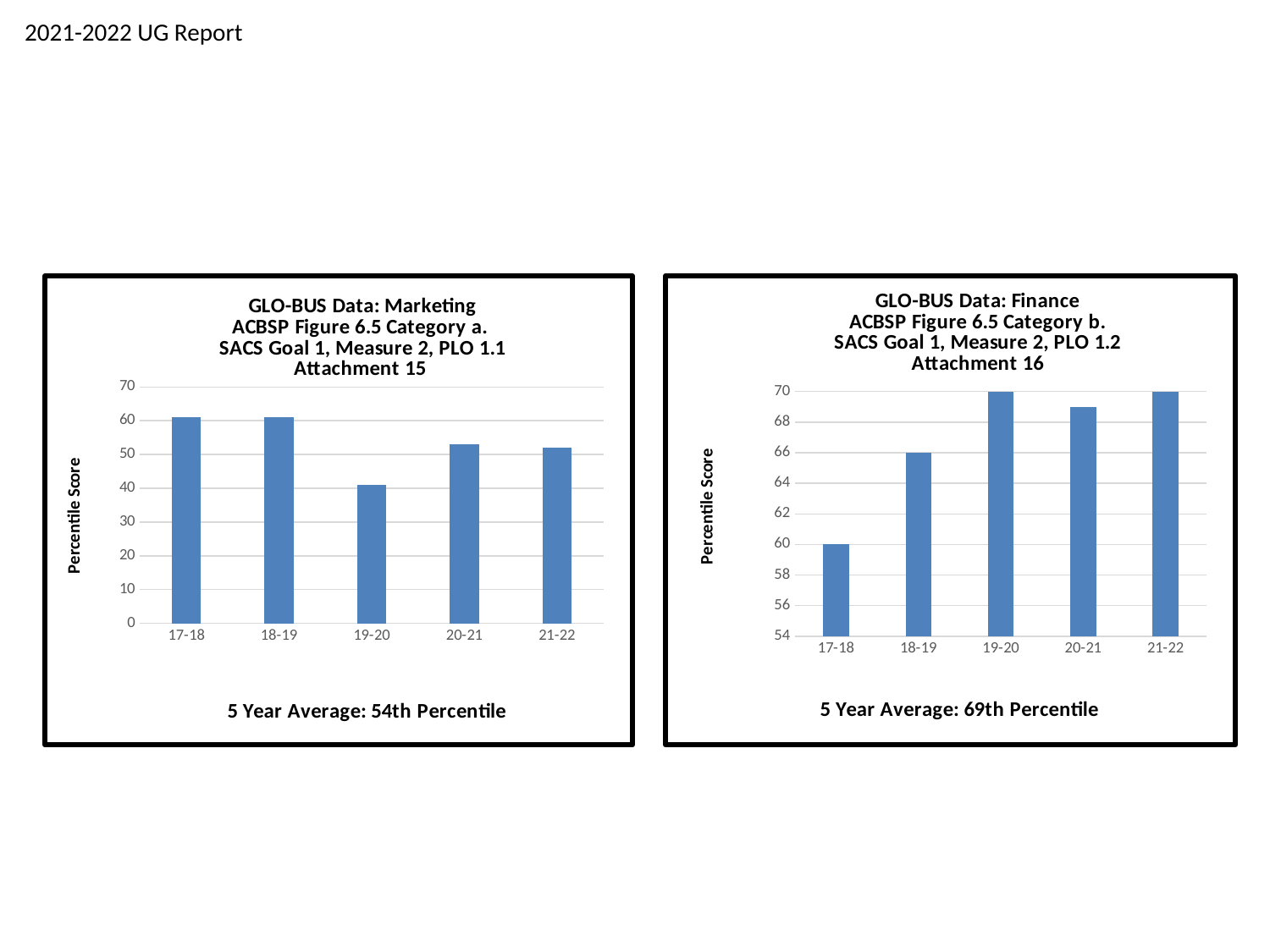
In the GLO-BUS Data: Marketing chart, which is larger, the value for 17-18 or the value for 19-20? 17-18 In the GLO-BUS Data: Marketing chart, is the value for 17-18 greater or less than 50? greater In the GLO-BUS Data: Finance chart, what is the percentile score for 17-18? 60 How many years are plotted in the GLO-BUS Data: Marketing chart? 5 What 5 year average is stated below the GLO-BUS Data: Finance chart? 69th Percentile In the GLO-BUS Data: Marketing chart, which year has the lowest percentile score? 19-20 What kind of chart is the GLO-BUS Data: Finance chart? bar chart In the GLO-BUS Data: Finance chart, which year has the lowest percentile score? 17-18 In the GLO-BUS Data: Finance chart, which is larger, the value for 18-19 or the value for 20-21? 20-21 In the GLO-BUS Data: Marketing chart, is the value for 19-20 greater or less than 50? less